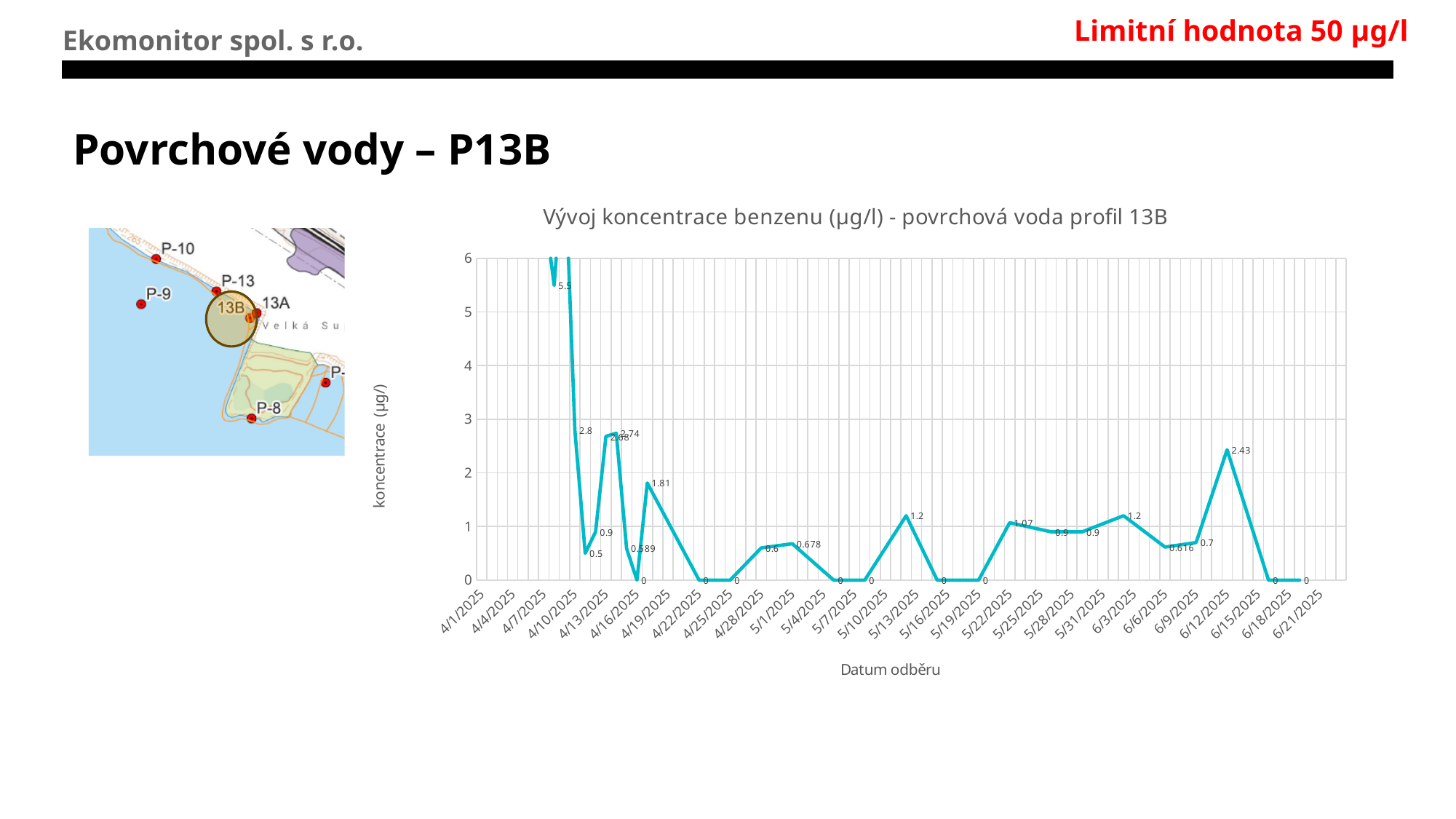
What kind of chart is shown on the slide? line chart What is the benzene concentration on 6/12/2025? 2.43 What is the benzene concentration on 5/1/2025? 0.678 What is the title of the x axis? Datum odběru What is the benzene concentration on 5/22/2025? 1.07 Is the value for 6/12/2025 greater or less than 2? greater Do the values rise or fall between 6/12/2025 and 6/15/2025? fall What is the title of the y axis? koncentrace (µg/l)